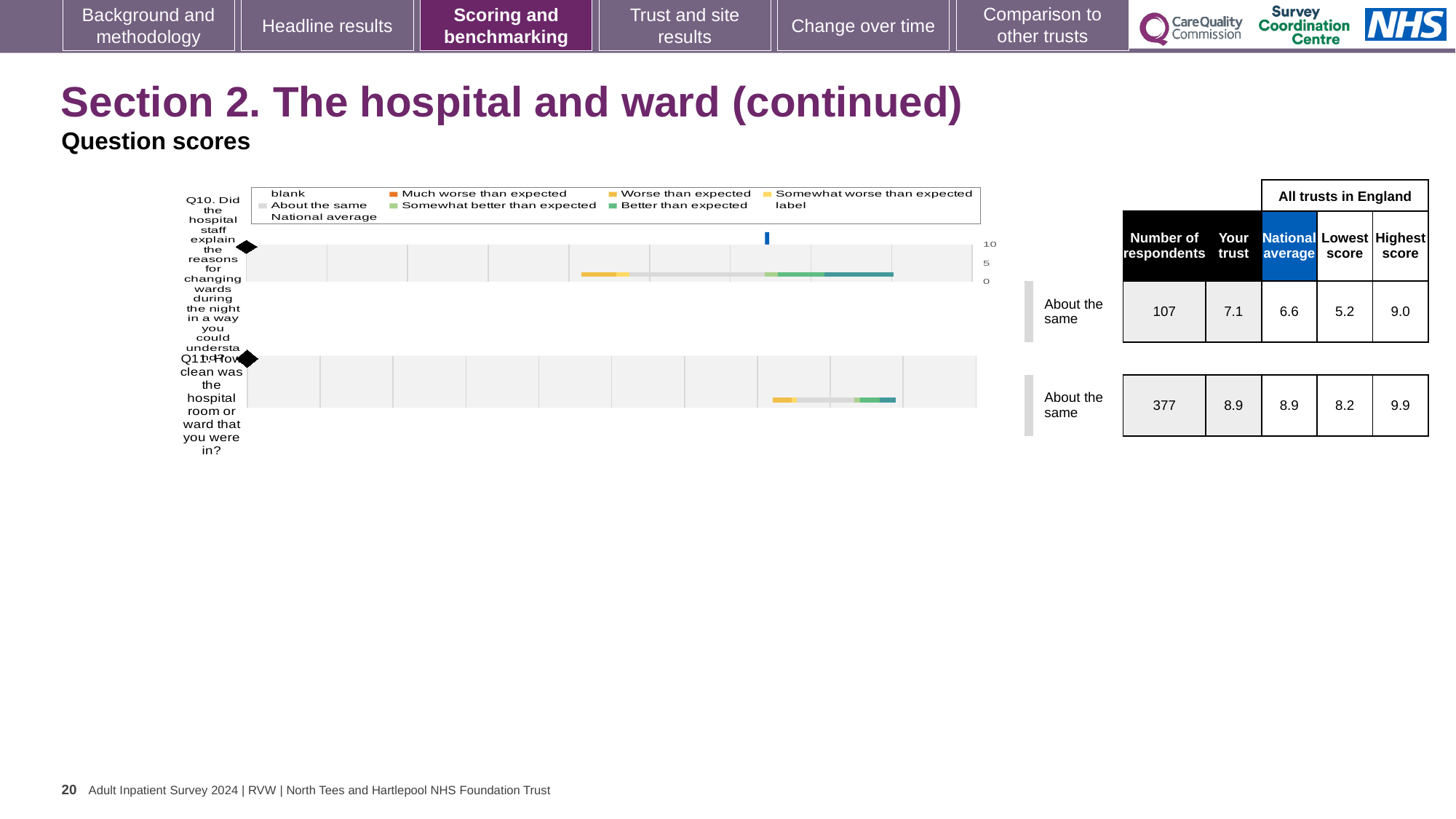
What is the lowest score across all trusts in England for Q10? 5.2 According to the table beside the chart, what is the 'Your trust' score for Q11? 8.9 What is the highest tick value shown on the chart's axis? 10 What benchmark category is given for both Q10 and Q11 next to the chart? About the same What is the difference between the 'Your trust' scores for Q11 and Q10? 1.8 How many respondents answered Q11 according to the table? 377 According to the table beside the chart, what is the 'Your trust' score for Q10? 7.1 What is the national average score for Q10 shown in the table? 6.6 Which question has the higher 'Your trust' score, Q10 or Q11? Q11 What is the highest score across all trusts in England for Q11? 9.9 What kind of chart is used to show the question scores for Q10 and Q11? bar chart How many questions are plotted in the benchmarking chart on this slide? 2